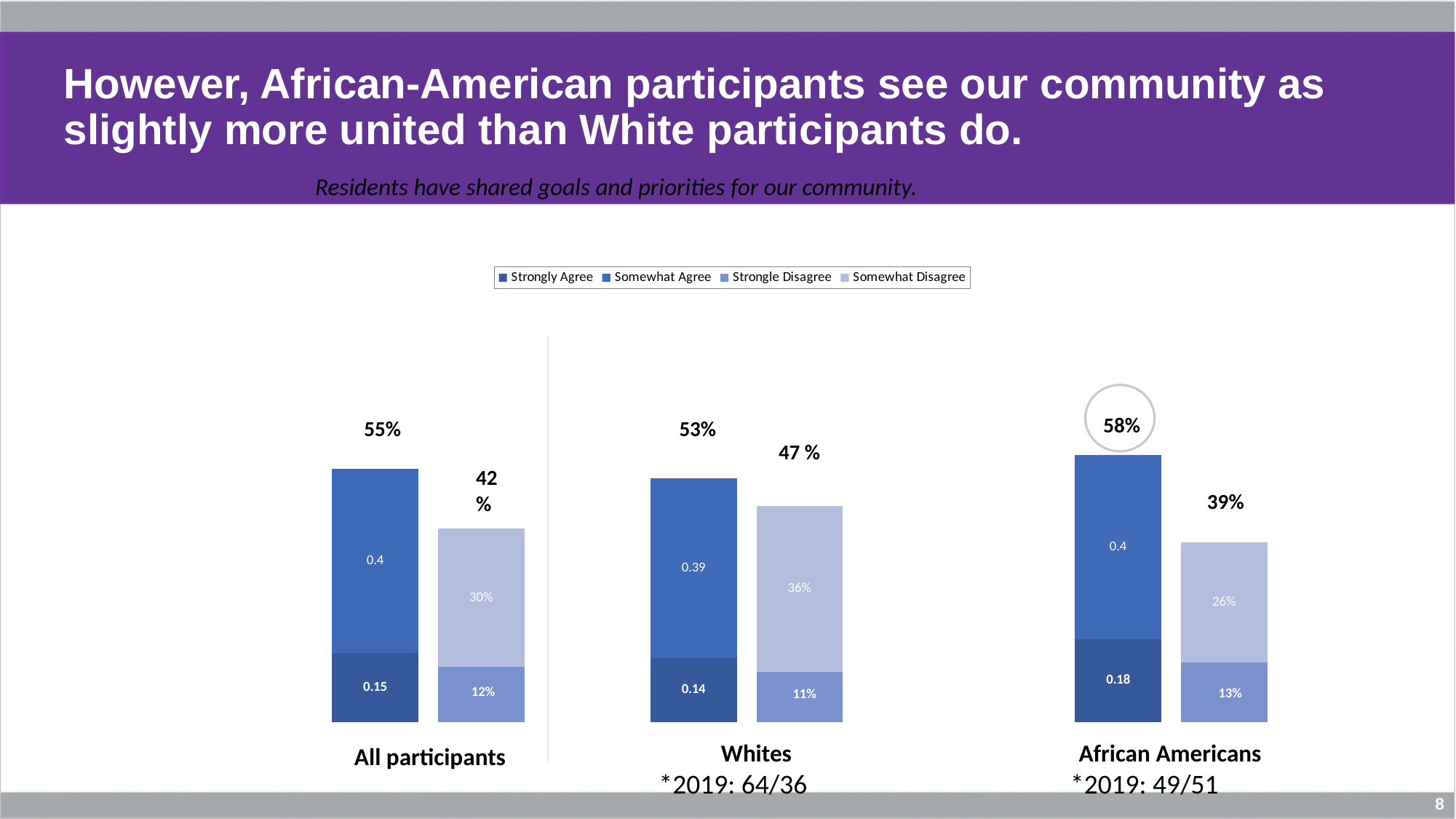
What is the difference between the total agreement percentages for African Americans and Whites? 5% How many series does the legend list? 4 What is the Somewhat Disagree value shown for All participants? 30% Which group has the highest total agreement percentage? African Americans Which group has the lowest total disagreement percentage? African Americans What is the Strongly Disagree value shown for African Americans? 13% What is the total agreement percentage shown above the agree bar for African Americans? 58% What is the Strongly Agree value shown for Whites? 0.14 What kind of chart is shown on the slide? Stacked bar chart How many groups of participants are shown on the x axis? 3 What is the total agreement percentage shown above the agree bar for Whites? 53% Which is larger for Whites: the total agreement percentage or the total disagreement percentage? Total agreement (53%)